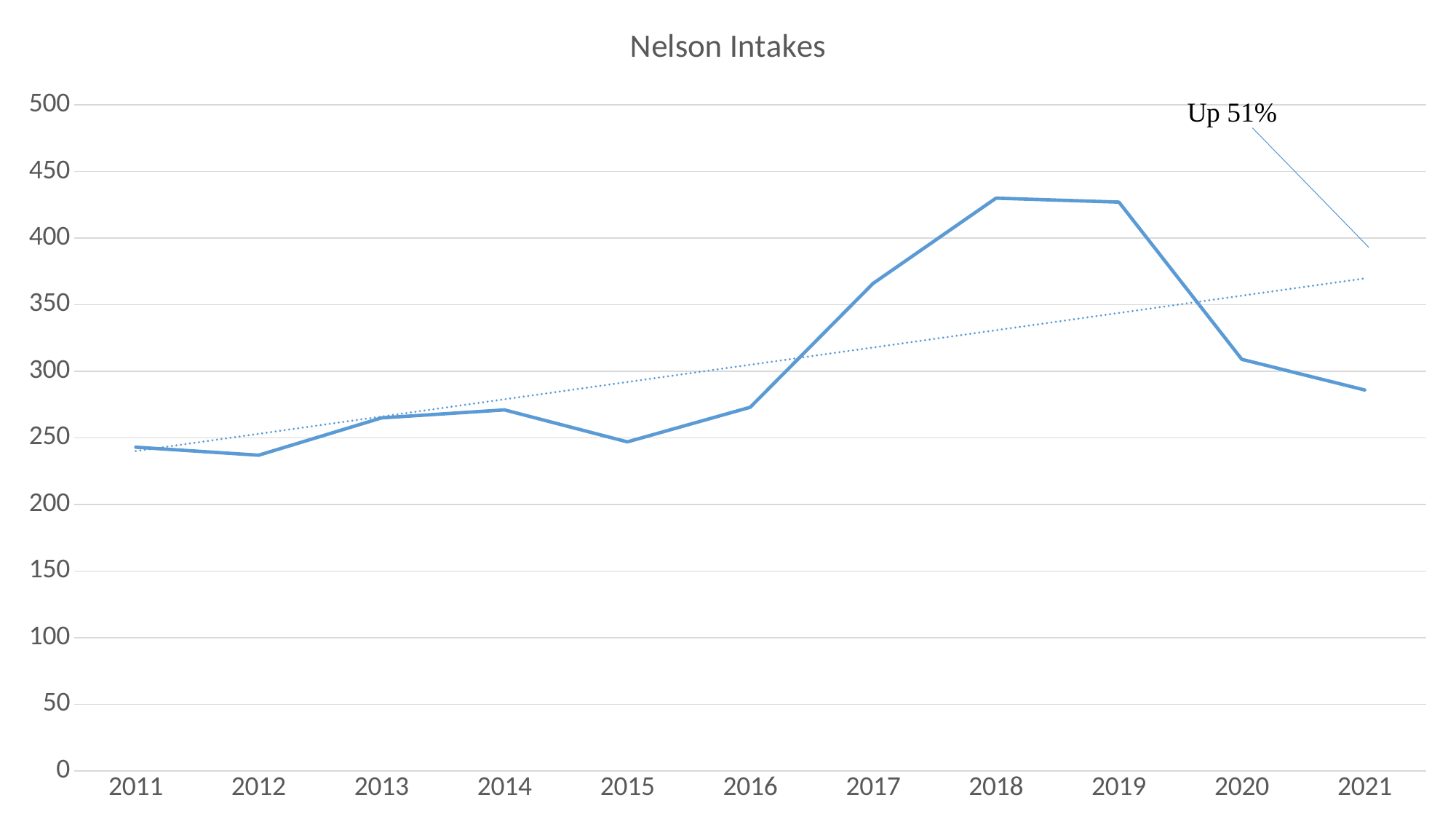
Is the value for 2012 greater or less than 250? less How many years are plotted along the x axis? 11 Is the value for 2021 greater or less than 300? less Is the value for 2017 greater or less than 350? greater What is the title of the chart? Nelson Intakes What does the annotation text on the chart say? Up 51% What kind of chart is shown on the slide? line chart Do the values rise or fall from 2019 to 2021? fall Which year has the larger value, 2016 or 2017? 2017 Which year has the larger value, 2018 or 2021? 2018